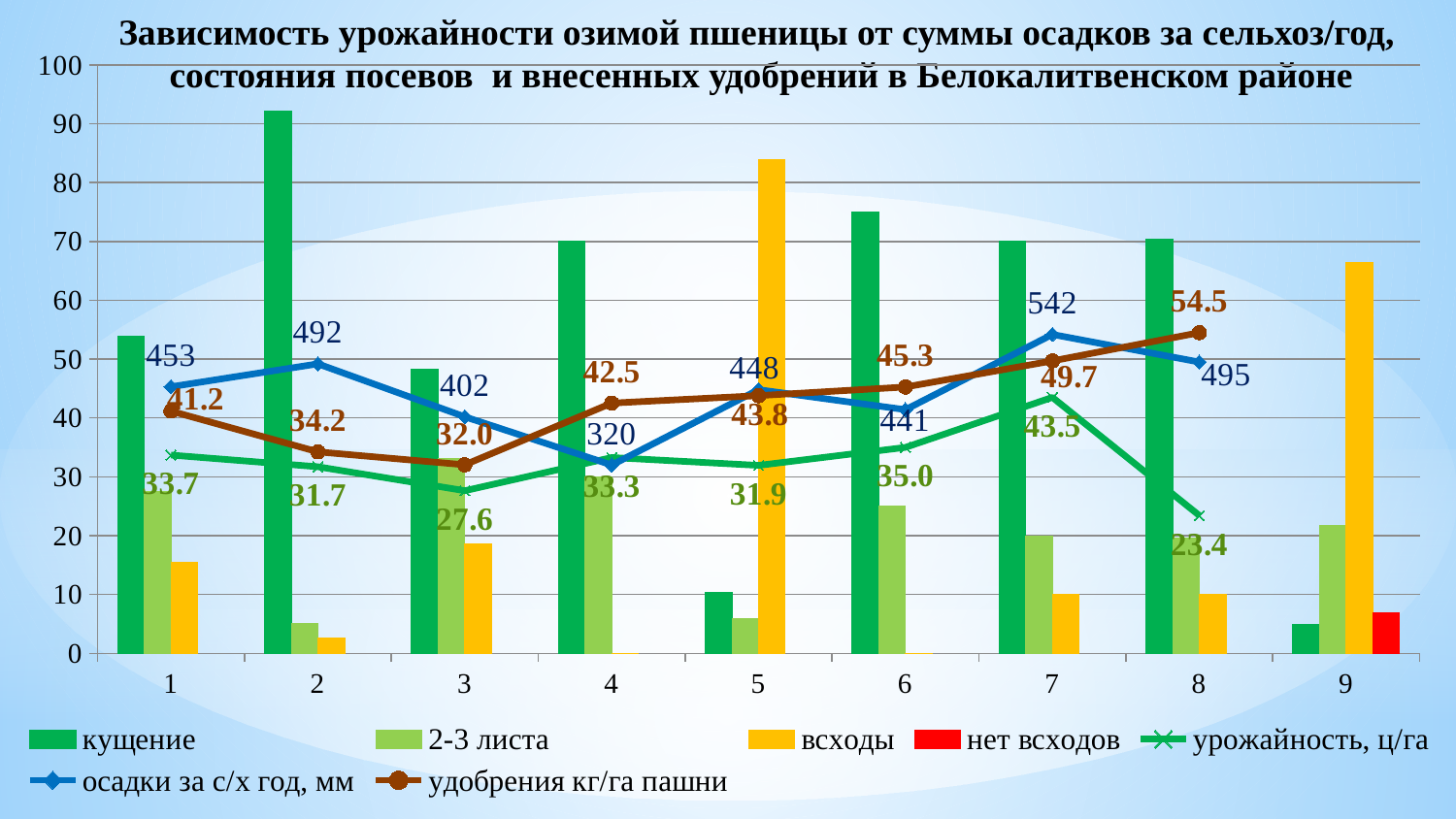
Which category has the highest value for осадки за с/х год, мм? 7 What is the value of удобрения кг/га пашни for category 8? 54.5 What is the value of осадки за с/х год, мм for category 7? 542 Which category has the lowest value for урожайность, ц/га? 8 Does the удобрения кг/га пашни series rise or fall from category 3 to category 8? rise How many series does the legend list? 7 Is the value of the всходы bar for category 5 greater or less than 80? greater Which is larger: урожайность, ц/га for category 1 or for category 2? category 1 What is the value of урожайность, ц/га for category 3? 27.6 Is the value of the кущение bar for category 2 greater or less than 90? greater What is the difference between урожайность, ц/га for category 7 and category 8? 20.1 How many categories are shown on the x axis? 9